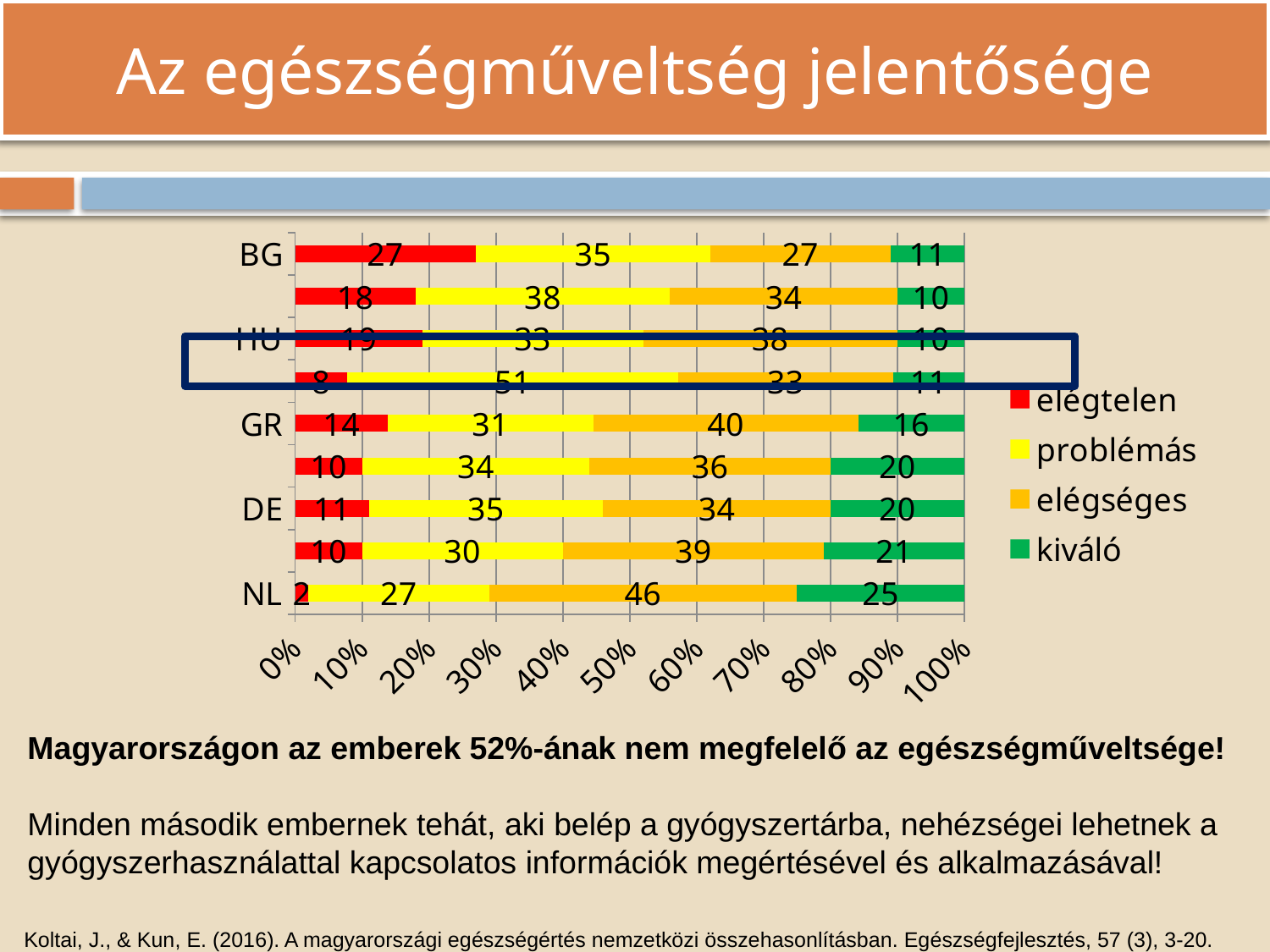
What is the value of the elégtelen segment for BG? 27 How many series does the legend list? 4 What kind of chart is shown on the slide? Stacked bar chart What is the value of the problémás segment for GR? 31 Which labelled country has the lowest elégtelen value? NL Which has the larger kiváló value, BG or NL? NL Which labelled country has the highest elégtelen value? BG What is the total of the stacked bar for BG? 100 What is the value of the kiváló segment for NL? 25 What is the value of the elégséges segment for HU? 38 What is the value of the kiváló segment for DE? 20 What is the difference between the elégtelen values for BG and NL? 25